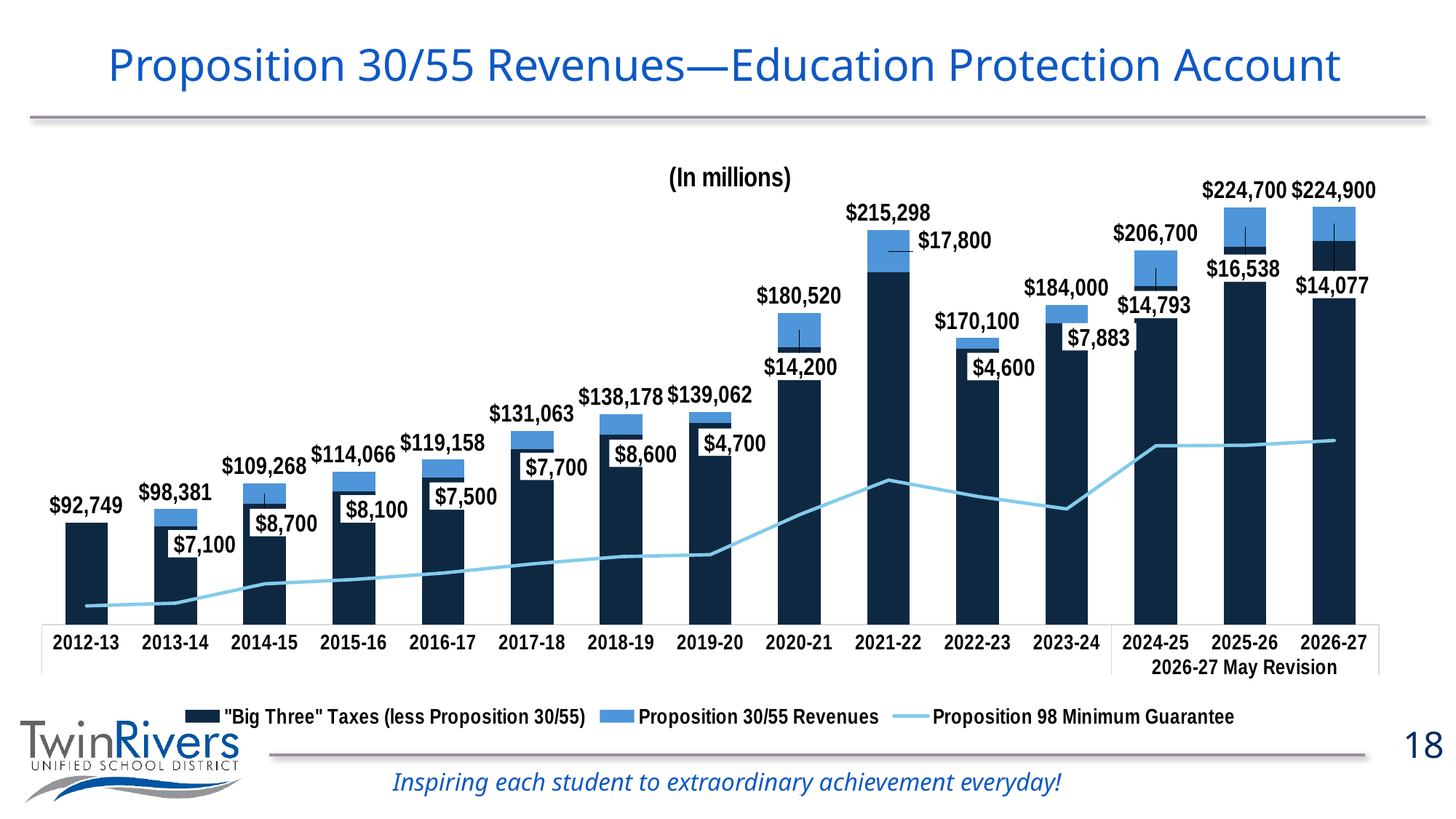
Which year has the larger Proposition 30/55 Revenues value, 2024-25 or 2023-24? 2024-25 What is the difference between the totals labeled above the bars for 2026-27 and 2025-26? $200 Which fiscal year has the highest labeled Proposition 30/55 Revenues value? 2021-22 What total is labeled above the bar for 2012-13? $92,749 What kind of chart is shown on the slide? combination bar and line chart How many series does the legend list? 3 What is the Proposition 30/55 Revenues value labeled for 2021-22? $17,800 How many fiscal years are shown along the x axis? 15 Does the Proposition 98 Minimum Guarantee line generally rise or fall from 2012-13 to 2026-27? rise What unit note is printed above the chart? (In millions) What is the Proposition 30/55 Revenues value labeled for 2023-24? $7,883 Which fiscal year has the lowest labeled Proposition 30/55 Revenues value? 2022-23